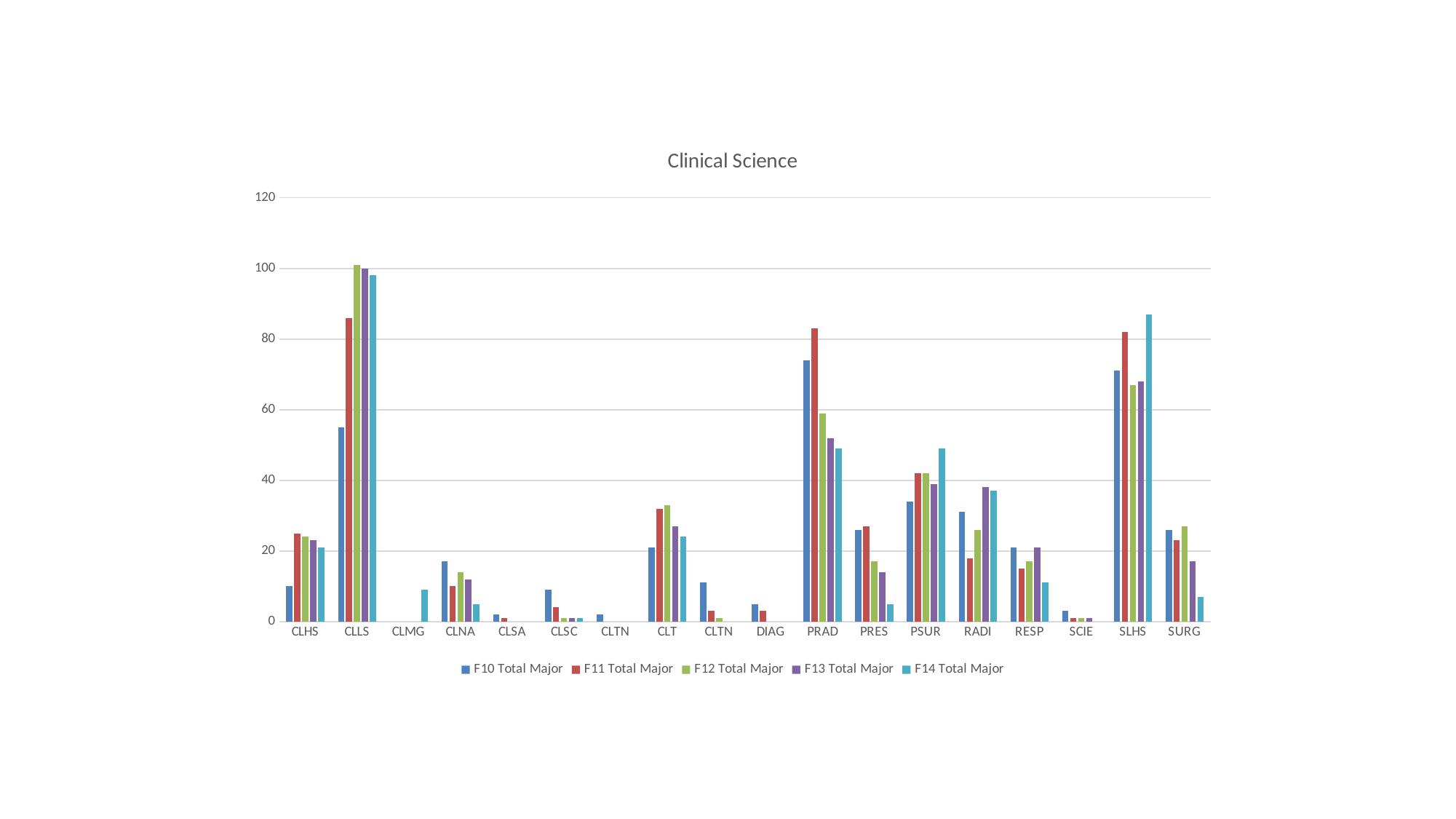
Which is larger for SURG: the F12 Total Major value or the F14 Total Major value? F12 Total Major Is the F10 Total Major value for CLLS greater or less than 60? less How many categories are shown on the x axis? 18 Which category has the highest F14 Total Major value? CLLS Is the F11 Total Major value for PRAD greater or less than 80? greater Which is larger for PRAD: the F10 Total Major value or the F12 Total Major value? F10 Total Major What is the title of the chart? Clinical Science How many series does the legend list? 5 Which series is shown in red in the legend? F11 Total Major Which category has the tallest bar in the chart? CLLS Is the F14 Total Major value for PSUR greater or less than 40? greater What type of chart is shown on the slide? Bar chart